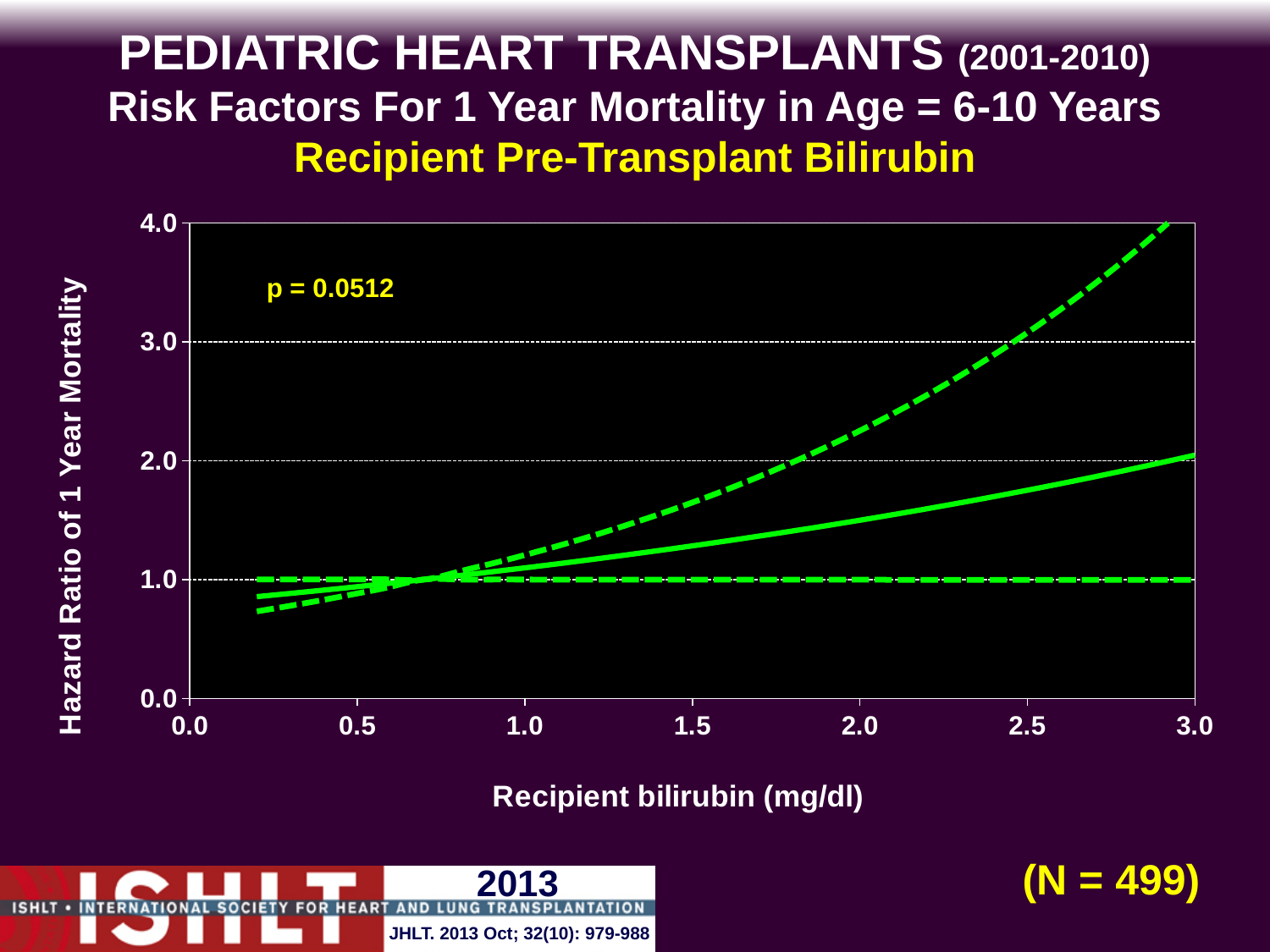
Does the solid line for hazard ratio rise or fall as recipient bilirubin increases from 1.0 to 3.0 mg/dl? rise What is the maximum value shown on the y axis of the chart? 4.0 Is the value of the solid hazard ratio line at a recipient bilirubin of 2.0 mg/dl greater or less than 2.0? less How many lines are plotted on the chart? 3 What is the p-value shown on the chart? p = 0.0512 What kind of chart is shown on the slide? line chart Is the value of the solid hazard ratio line at a recipient bilirubin of 2.0 mg/dl greater or less than 1.0? greater What is the label of the x axis of the chart? Recipient bilirubin (mg/dl) What is the maximum value shown on the x axis of the chart? 3.0 Is the value of the upper dashed line at a recipient bilirubin of 2.0 mg/dl greater or less than 1.0? greater